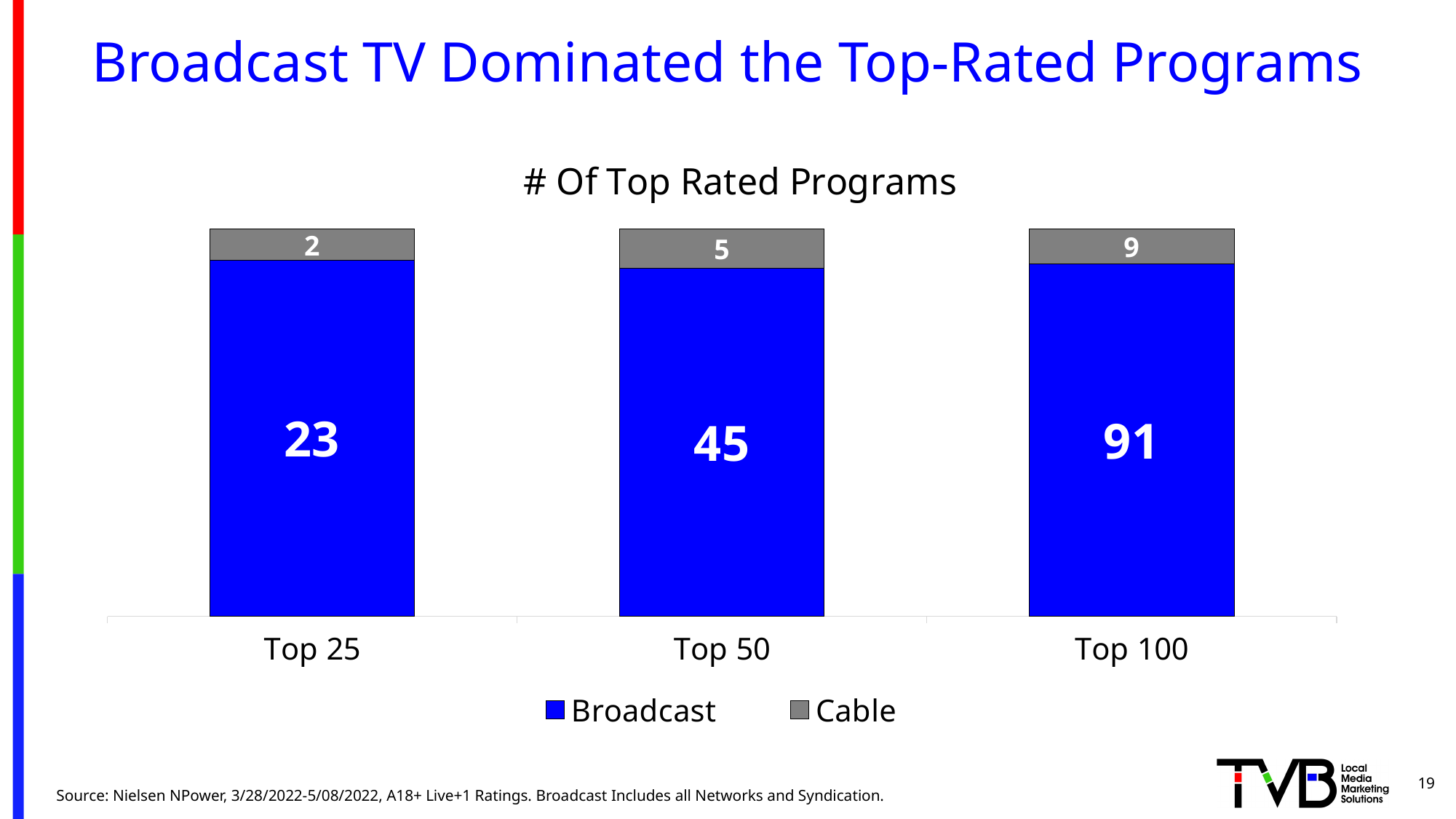
What is the Cable value for Top 100? 9 Which category has the highest Broadcast value? Top 100 How many series does the legend list? 2 What is the Cable value for Top 50? 5 What is the Broadcast value for Top 50? 45 What is the total of the stacked bar for Top 50? 50 What is the difference between the Broadcast values for Top 100 and Top 50? 46 What kind of chart is shown? Stacked bar chart Which category has the lowest Cable value? Top 25 How many categories are shown on the x axis? 3 What is the Broadcast value for Top 25? 23 Which is larger: the Broadcast value for Top 25 or the Cable value for Top 100? Broadcast value for Top 25